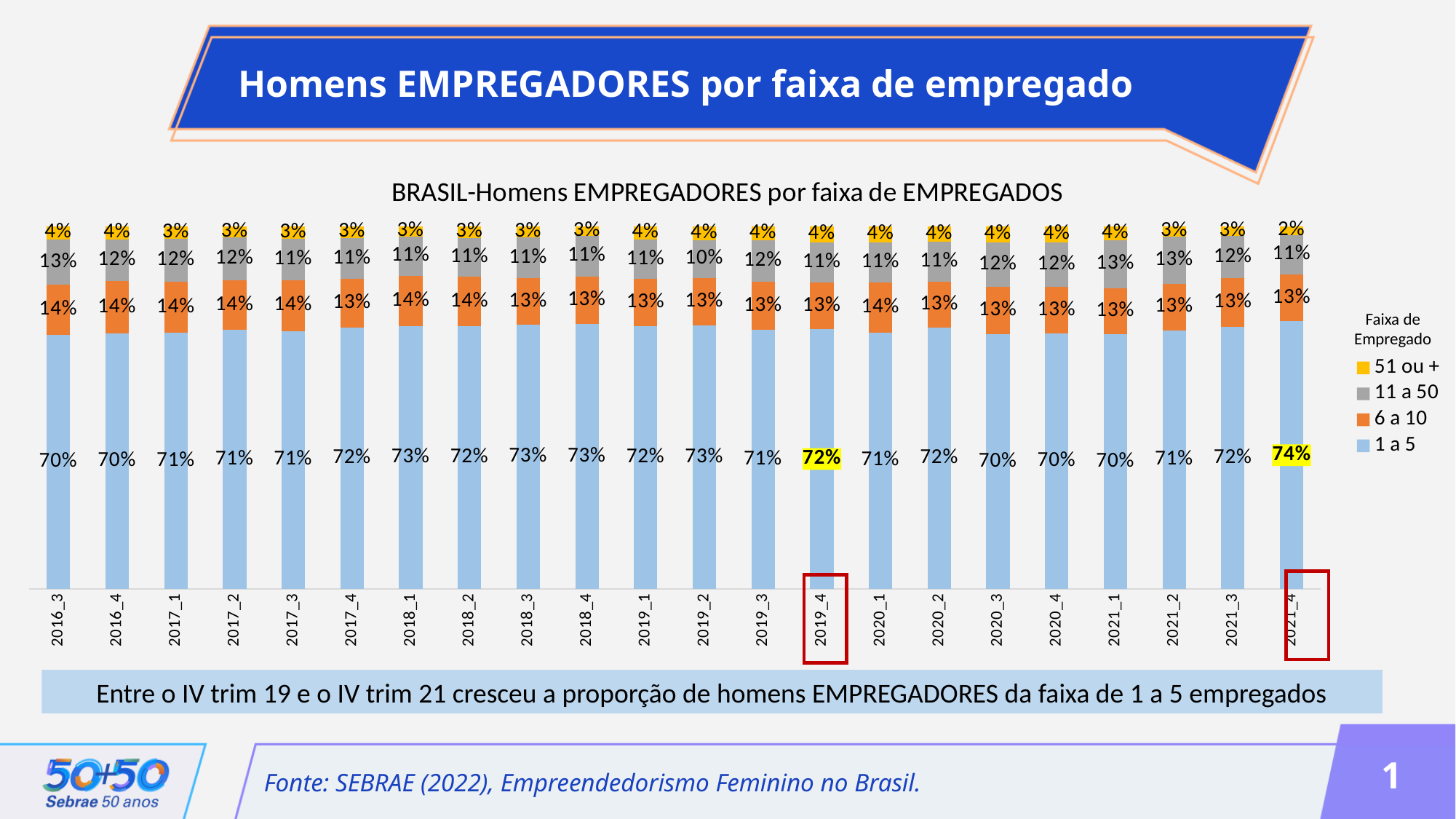
What kind of chart is shown? Stacked bar chart In which period is the '1 a 5' series highest? 2021_4 By how many percentage points did the '1 a 5' share change from 2019_4 to 2021_4? 2 percentage points What is the total of the stacked bar for 2019_4? 100% How many series does the legend list? 4 What is the value for the '11 a 50' series in 2016_3? 13% What is the value for the '1 a 5' series in 2019_4? 72% How many periods (bars) are shown on the x axis? 22 What is the value for the '1 a 5' series in 2021_4? 74% Which is larger in 2016_3: the '6 a 10' share or the '11 a 50' share? 6 a 10 In which period is the '11 a 50' series lowest? 2019_2 What is the value for the '51 ou +' series in 2021_4? 2%